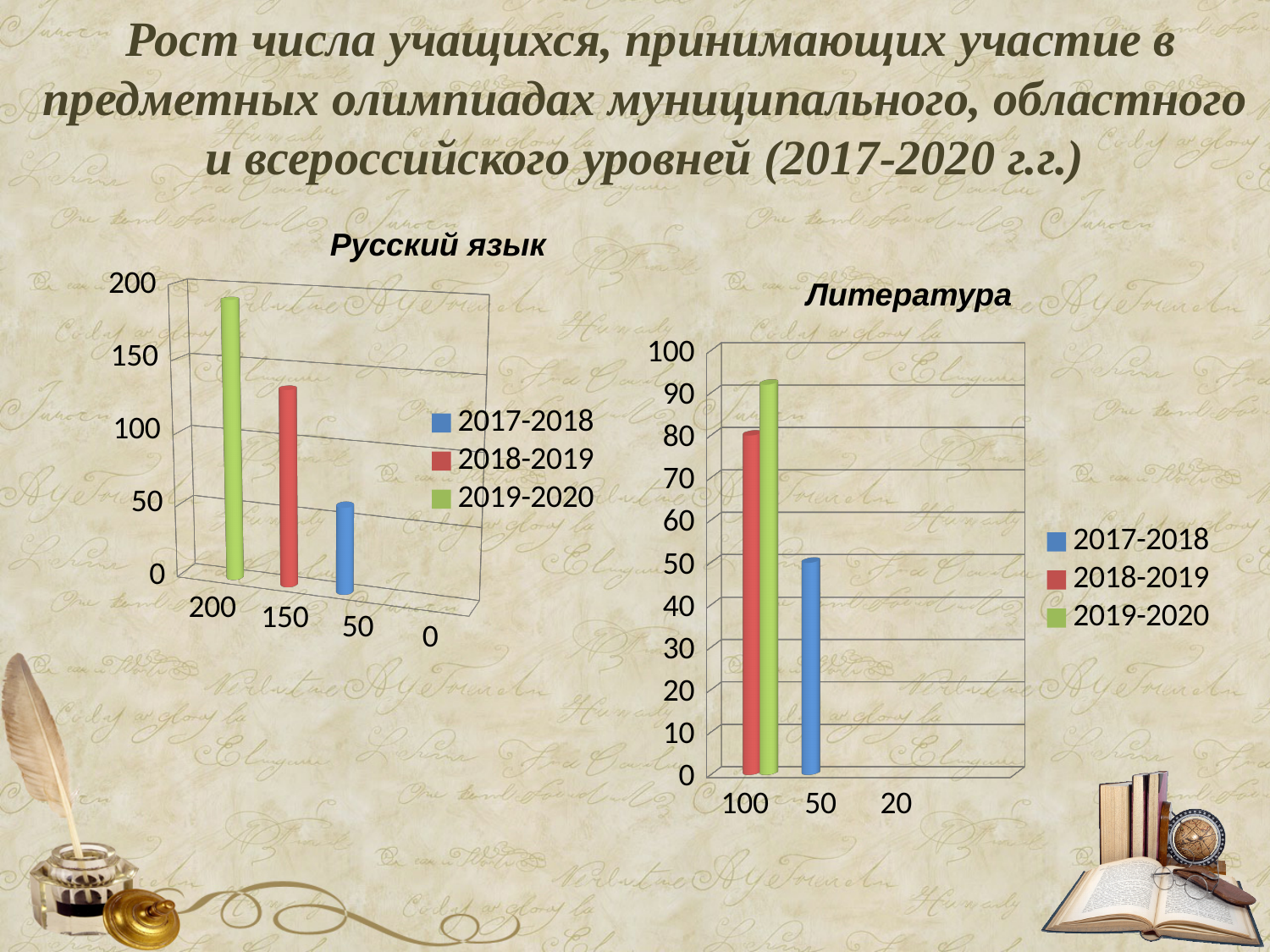
In the "Литература" chart, is the value for 2017-2018 greater or less than 60? less In the "Литература" chart, which series has the lowest bar? 2017-2018 In the "Русский язык" chart, which series has the lowest bar? 2017-2018 In the "Русский язык" chart, what colour is the bar for 2018-2019? red In the "Литература" chart, is the value for 2018-2019 greater or less than 90? less In the "Русский язык" chart, which series has the highest bar? 2019-2020 How many series does the legend of the "Литература" chart list? 3 In the "Русский язык" chart, is the value for 2018-2019 greater or less than 100? greater What kind of chart is the "Русский язык" chart? bar chart In the "Литература" chart, which is larger, the value for 2018-2019 or the value for 2017-2018? 2018-2019 In the "Литература" chart, which series has the highest bar? 2019-2020